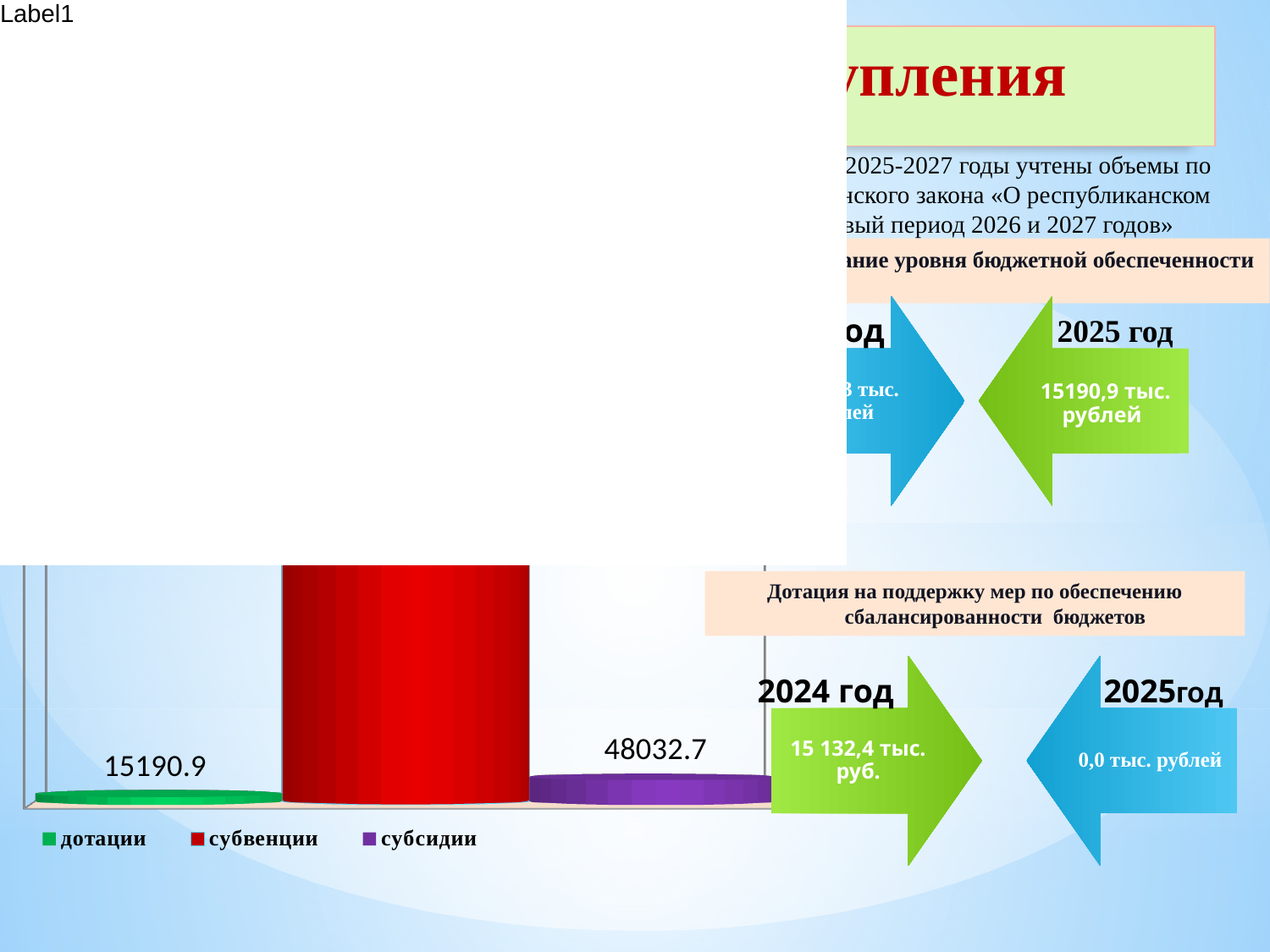
Which series has the smallest bar in the chart? дотации What kind of chart is shown on the slide? bar chart What is the value shown for субсидии in the bar chart? 48032.7 What is the value shown for дотации in the bar chart? 15190.9 What is the difference between the value for субсидии and the value for дотации? 32841.8 What colour represents субвенции in the chart legend? red How many bars are plotted in the chart? 3 Which is larger, the value for субсидии or the value for дотации? субсидии Which series has the tallest bar in the chart? субвенции How many series does the chart legend list? 3 What colour represents дотации in the chart legend? green